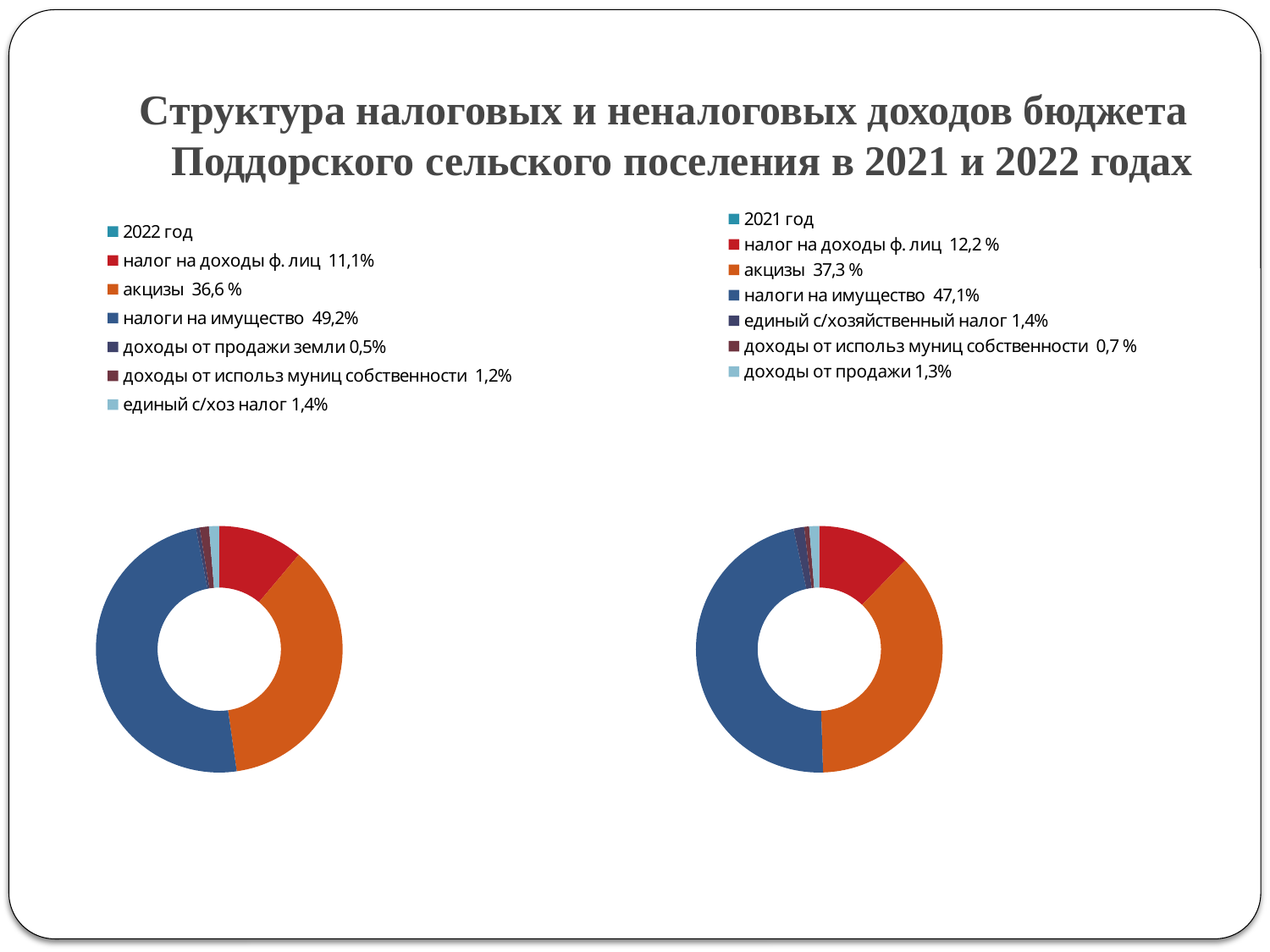
In the 2022 chart (left), which category has the largest share? налоги на имущество What type of chart is used on this slide? Doughnut (pie) chart In the 2022 chart (left), which category has the smallest share? доходы от продажи земли In the 2022 chart (left), how many categories with percentage values are listed in the legend? 6 In the 2021 chart (right), what share is shown for акцизы? 37,3 % In the 2021 chart (right), what share is shown for доходы от использ муниц собственности? 0,7 % Which is larger: the share of налог на доходы ф. лиц in 2022 (left chart) or in 2021 (right chart)? 2021 In the 2022 chart (left), what share is shown for налог на доходы ф. лиц? 11,1% How many charts are shown on the slide? 2 In the 2022 chart (left), what share is shown for налоги на имущество? 49,2% In the 2021 chart (right), what is the difference between the shares of налоги на имущество and акцизы? 9,8 percentage points In the 2021 chart (right), which category has the smallest share? доходы от использ муниц собственности